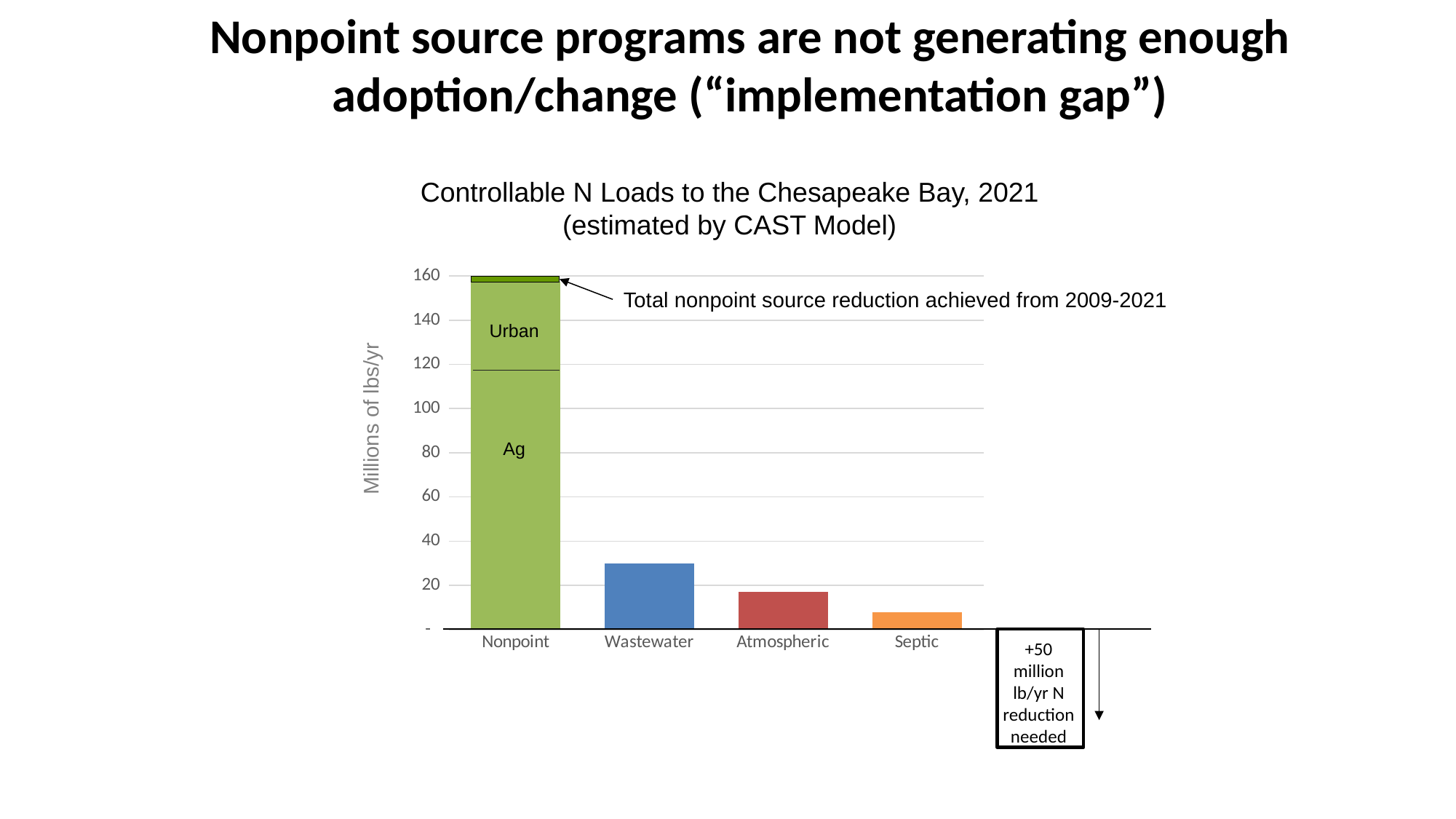
Is the value for Wastewater greater or less than 40? less Is the value for Nonpoint greater or less than 140? greater How many categories are plotted along the x axis of the chart? 4 Which category has the lowest controllable N load? Septic Is the value for Atmospheric greater or less than 20? less Which is larger, the value for Wastewater or the value for Atmospheric? Wastewater Which category has the highest controllable N load? Nonpoint What is the label on the y axis of the chart? Millions of lbs/yr What is the title of the chart? Controllable N Loads to the Chesapeake Bay, 2021 (estimated by CAST Model) What kind of chart is shown on the slide? bar chart